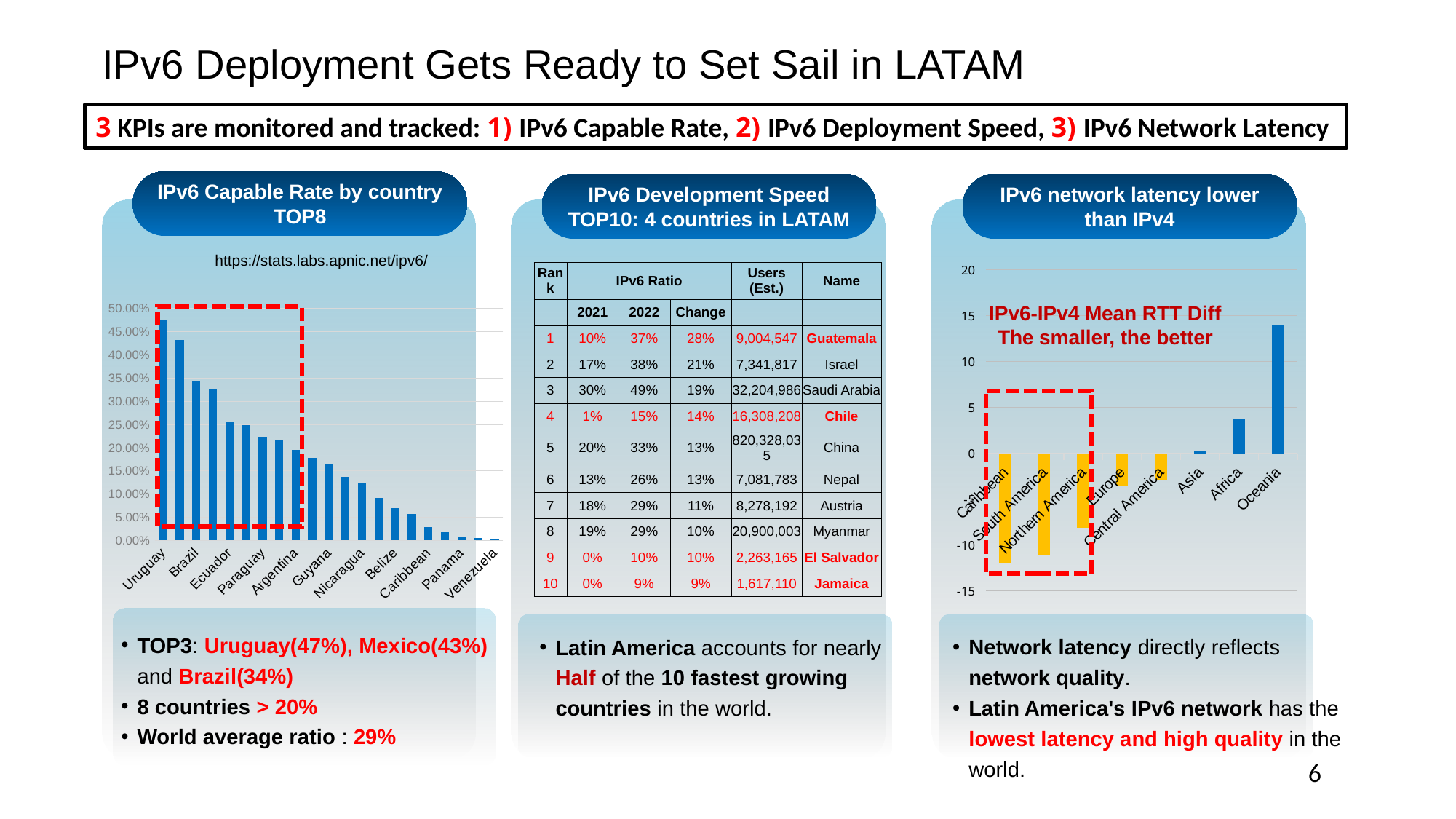
On the 'IPv6 Capable Rate by country TOP8' chart, is the value for Brazil greater or less than 30.00%? greater On the 'IPv6 Capable Rate by country TOP8' chart, which country has the highest IPv6 capable rate? Uruguay On the 'IPv6 network latency lower than IPv4' chart, which is larger, the value for Oceania or the value for Africa? Oceania On the 'IPv6 network latency lower than IPv4' chart, is the value for Caribbean greater or less than -10? less On the 'IPv6 network latency lower than IPv4' chart, what does the text inside the plot area say? IPv6-IPv4 Mean RTT Diff The smaller, the better What kind of chart is the 'IPv6 Capable Rate by country TOP8' chart? bar chart On the 'IPv6 network latency lower than IPv4' chart, which region has the highest IPv6-IPv4 mean RTT difference? Oceania On the 'IPv6 Capable Rate by country TOP8' chart, do the values rise or fall from left to right along the x axis? fall On the 'IPv6 network latency lower than IPv4' chart, how many regions are plotted? 8 On the 'IPv6 Capable Rate by country TOP8' chart, is the value for Uruguay greater or less than 45.00%? greater